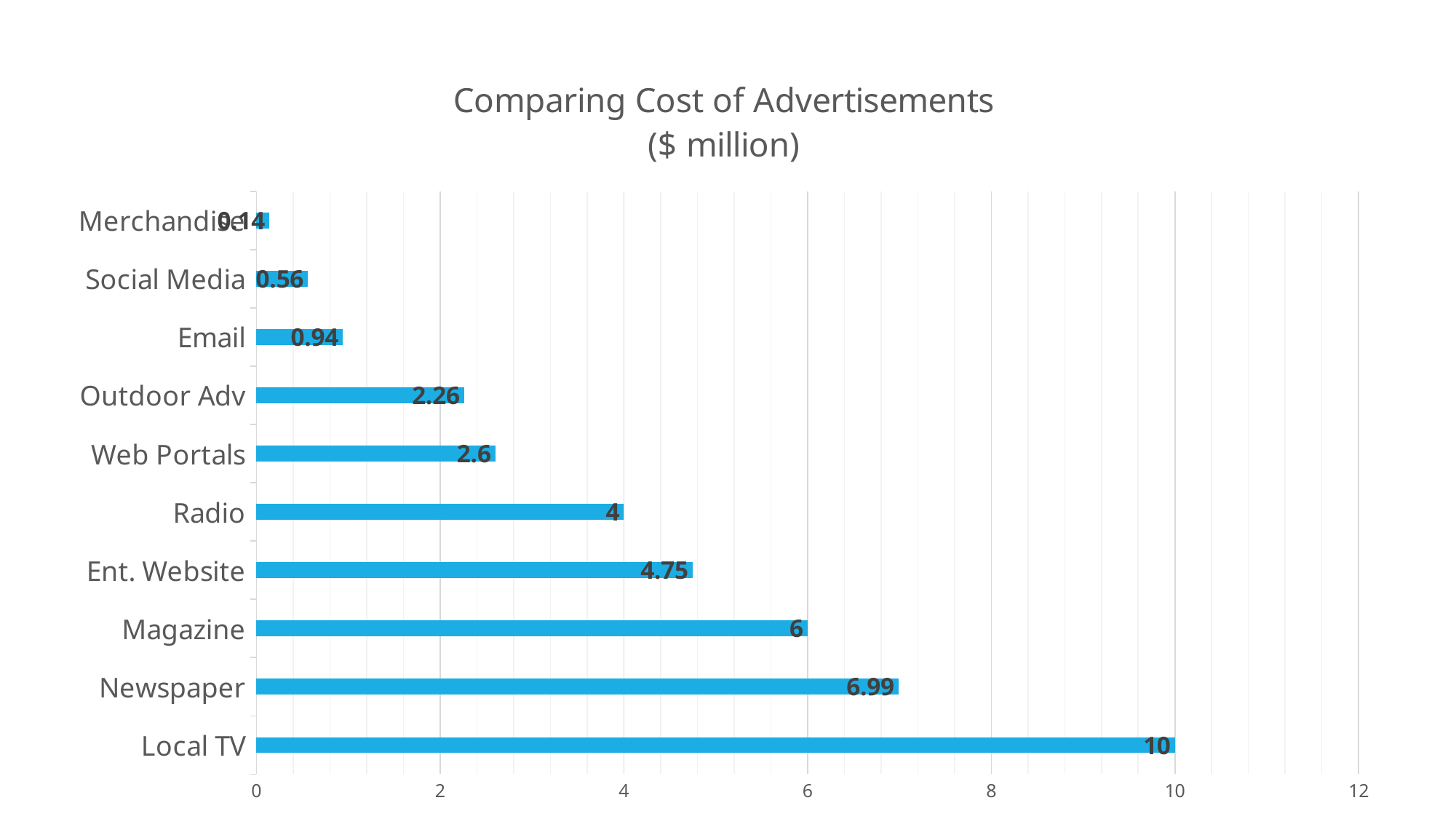
What is the difference in cost between Magazine and Radio? 2 Is the value for Newspaper greater or less than 6? greater What kind of chart is shown on the slide? Bar chart What is the cost of advertisements for Outdoor Adv? 2.26 What is the cost of advertisements for Newspaper? 6.99 What is the cost of advertisements for Local TV? 10 Which category has the highest advertisement cost? Local TV Which category has the lowest advertisement cost? Merchandise What is the title of the chart? Comparing Cost of Advertisements ($ million) How many categories are shown in the chart? 10 Which has a higher advertisement cost, Web Portals or Email? Web Portals What is the cost of advertisements for Ent. Website? 4.75